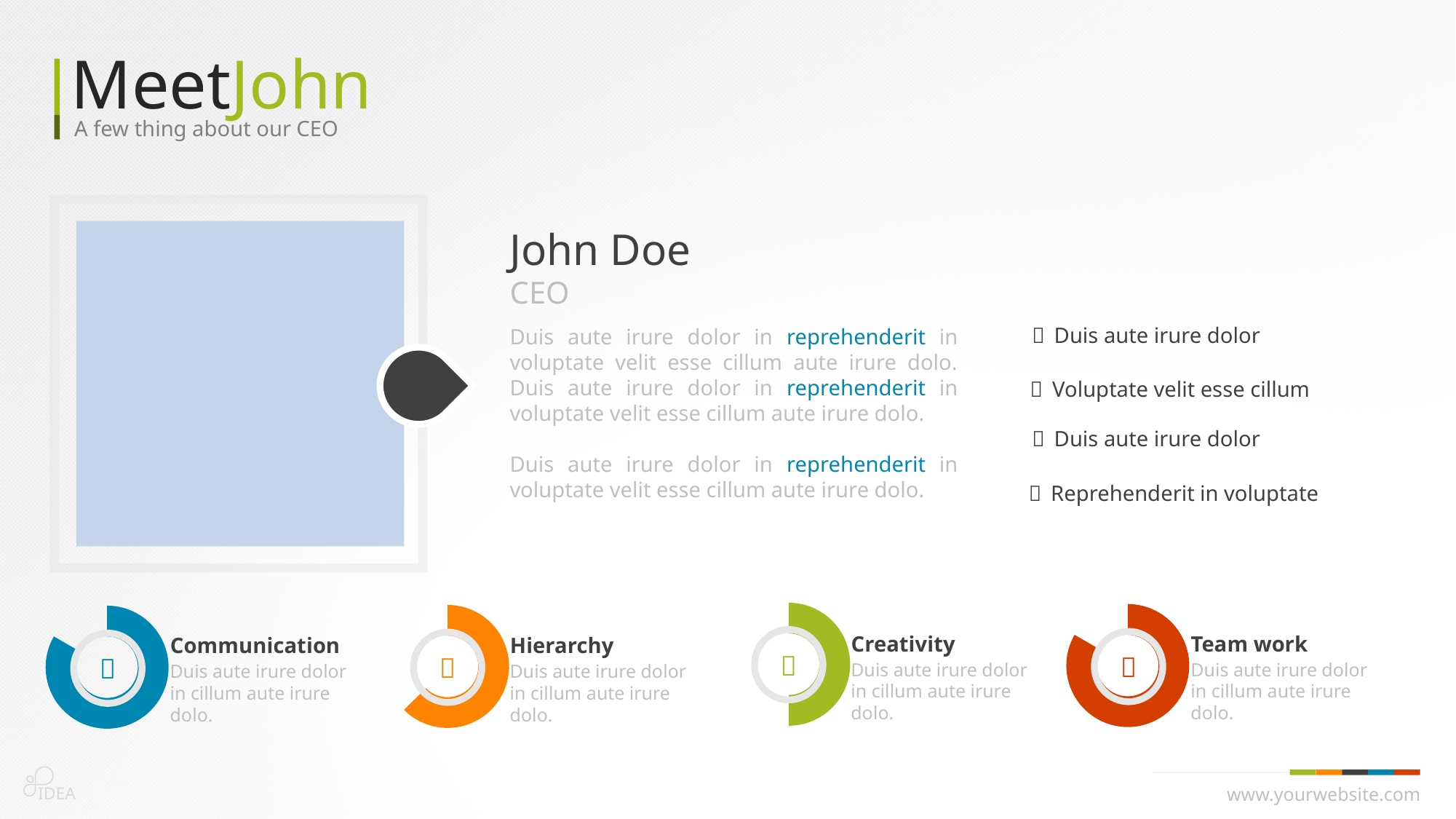
What colour is the Communication ring? Blue Which ring is more filled, Communication or Creativity? Communication What colour is the Creativity ring? Green How many ring charts are shown along the bottom of the slide? 4 Which ring is more filled, Team work or Hierarchy? Team work Which of the four ring charts has the largest filled portion? Communication and Team work (tied) What kind of chart is used for the Communication, Hierarchy, Creativity and Team work indicators? Ring (donut) chart